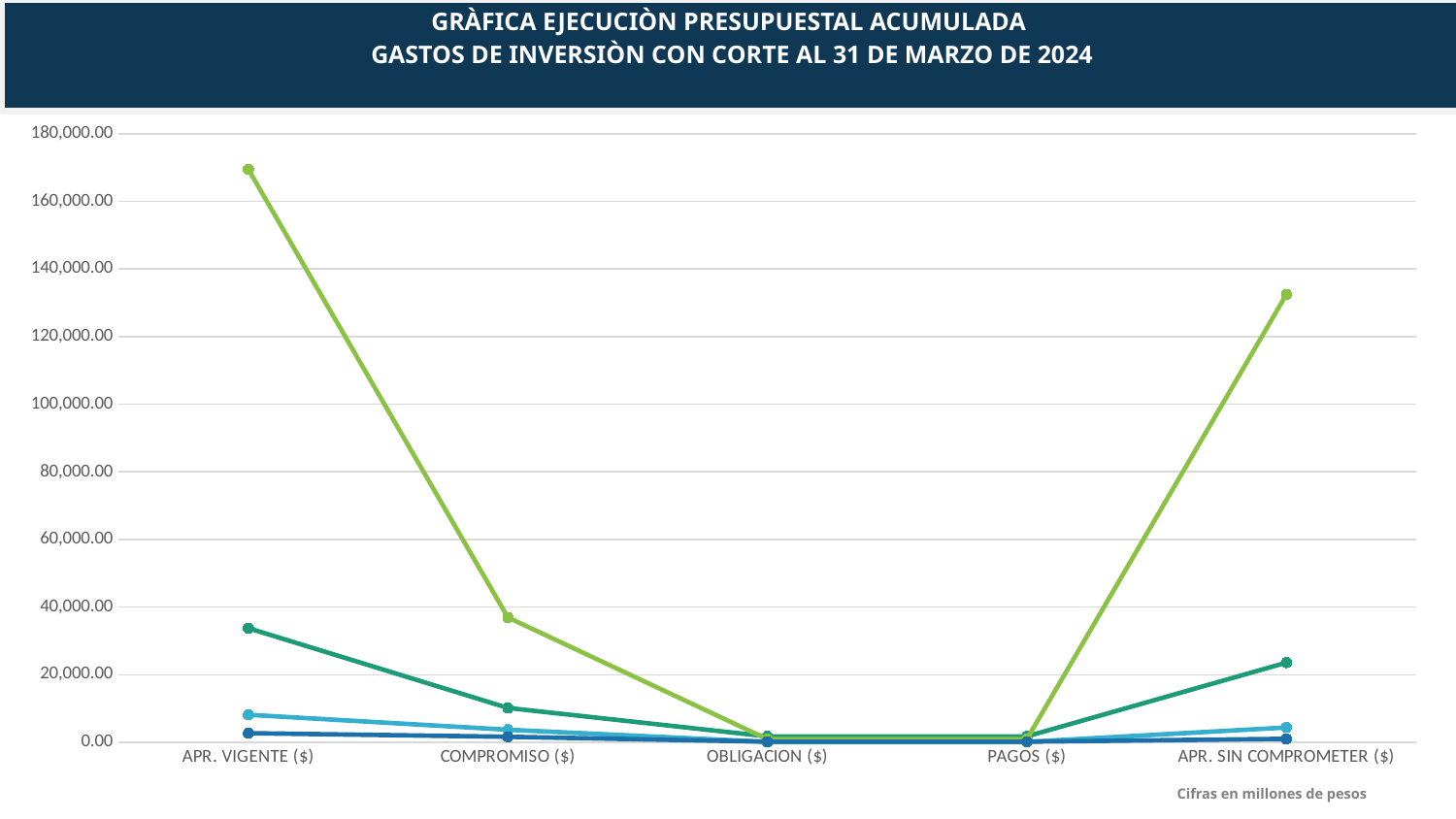
How many categories are shown on the x axis? 5 According to the note below the chart, in what units are the figures expressed? Millones de pesos How many lines are plotted on the chart? 4 What kind of chart is shown on the slide? Line chart Is the value of the light green line for APR. VIGENTE ($) greater or less than 160,000.00? greater Is the value of the dark green line for APR. VIGENTE ($) greater or less than 20,000.00? greater Is the value of the light green line for COMPROMISO ($) greater or less than 40,000.00? less For the light green line, which category has the highest value? APR. VIGENTE ($) For the light green line, which is larger: the value for APR. VIGENTE ($) or for APR. SIN COMPROMETER ($)? APR. VIGENTE ($) Does the light green line rise or fall from APR. VIGENTE ($) to OBLIGACION ($)? Fall For the dark green line, which is larger: the value for COMPROMISO ($) or for APR. SIN COMPROMETER ($)? APR. SIN COMPROMETER ($)